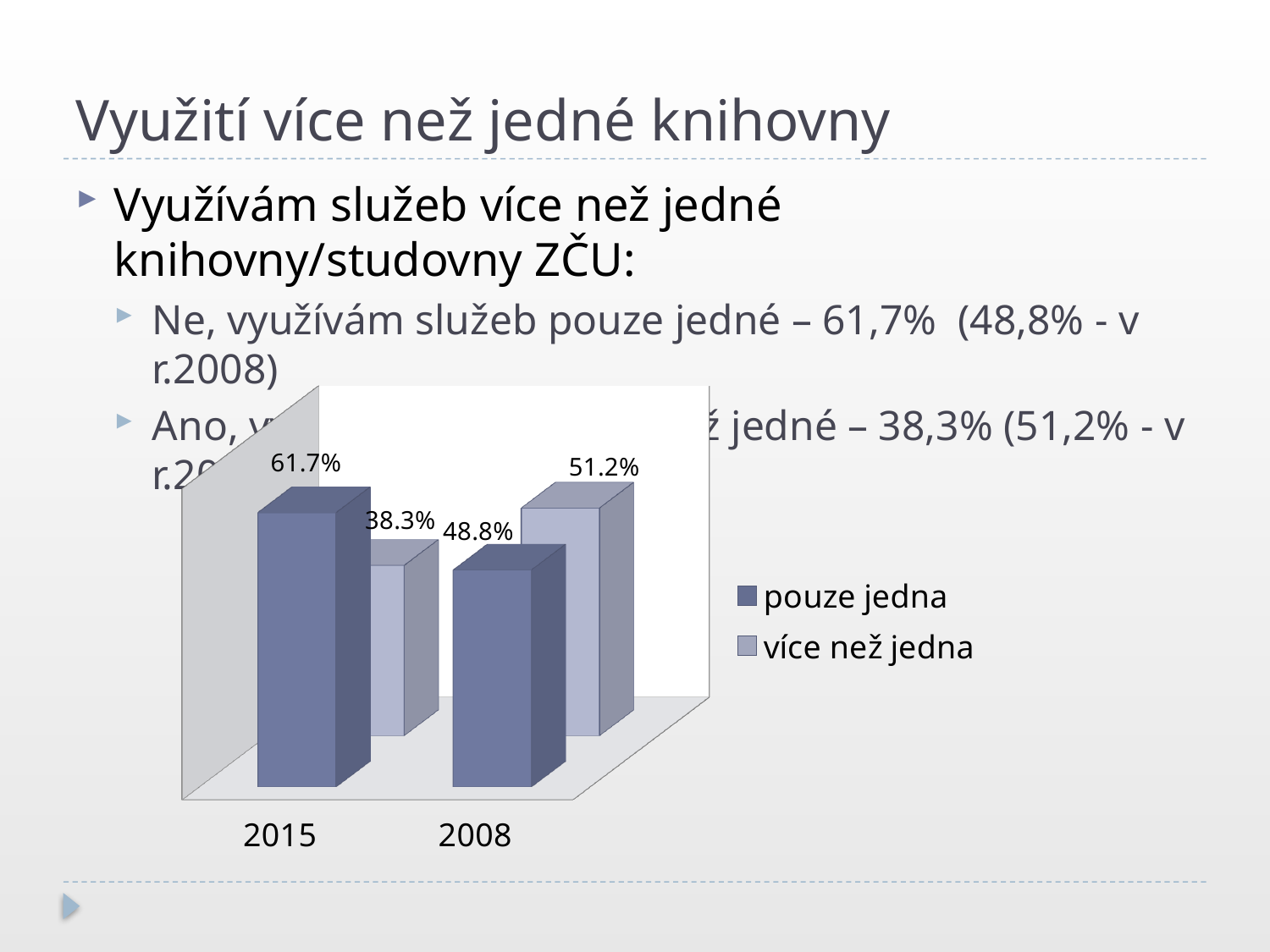
How many series does the chart legend list? 2 Which bar in the chart has the lowest value? více než jedna, 2015 What is the value for "pouze jedna" in 2008? 48.8% How many categories are shown on the x axis of the chart? 2 Which bar in the chart has the highest value? pouze jedna, 2015 What is the value for "více než jedna" in 2008? 51.2% What is the value for "více než jedna" in 2015? 38.3% In 2008, which is larger: "pouze jedna" or "více než jedna"? více než jedna What is the value for "pouze jedna" in 2015? 61.7% What is the difference between the "pouze jedna" values for 2015 and 2008? 12.9% What kind of chart is shown on the slide? bar chart What is the difference between "pouze jedna" and "více než jedna" in 2015? 23.4%